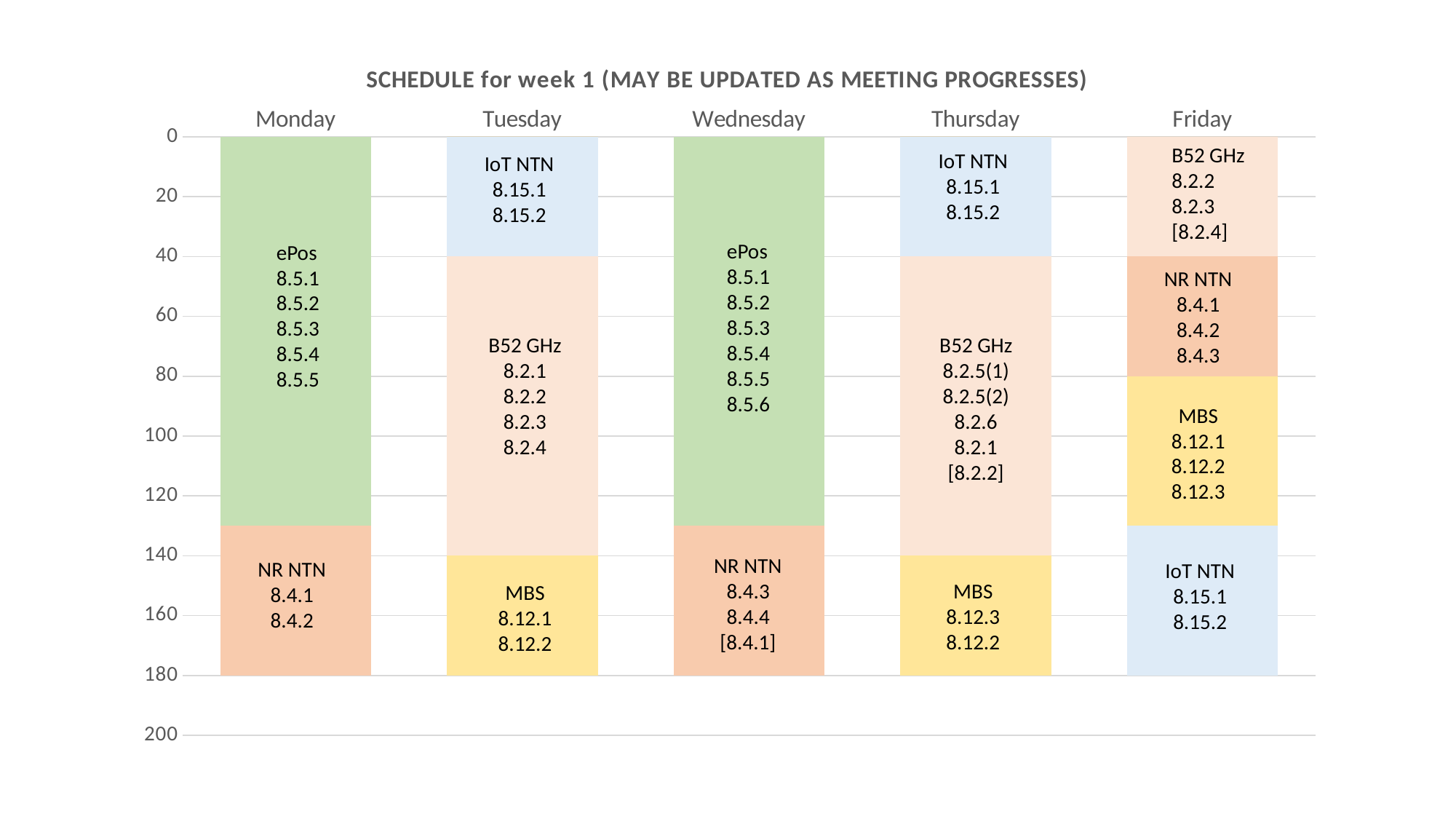
How many segments make up the Friday bar? 4 Is the length of the ePos segment on Monday greater or less than 100? greater At which axis value does the MBS segment on Thursday begin? 140 How many days (categories) are shown along the x axis? 5 At which axis value does the IoT NTN segment on Tuesday end? 40 Is the length of the MBS segment on Tuesday greater or less than 60? less Which is longer on Thursday, the B52 GHz segment or the MBS segment? B52 GHz What kind of chart is shown on the slide? stacked bar chart Which topic occupies the top segment of the Tuesday bar? IoT NTN At which axis value does the NR NTN segment on Friday end? 80 How many segments make up the Monday bar? 2 What is the title of the chart? SCHEDULE for week 1 (MAY BE UPDATED AS MEETING PROGRESSES)